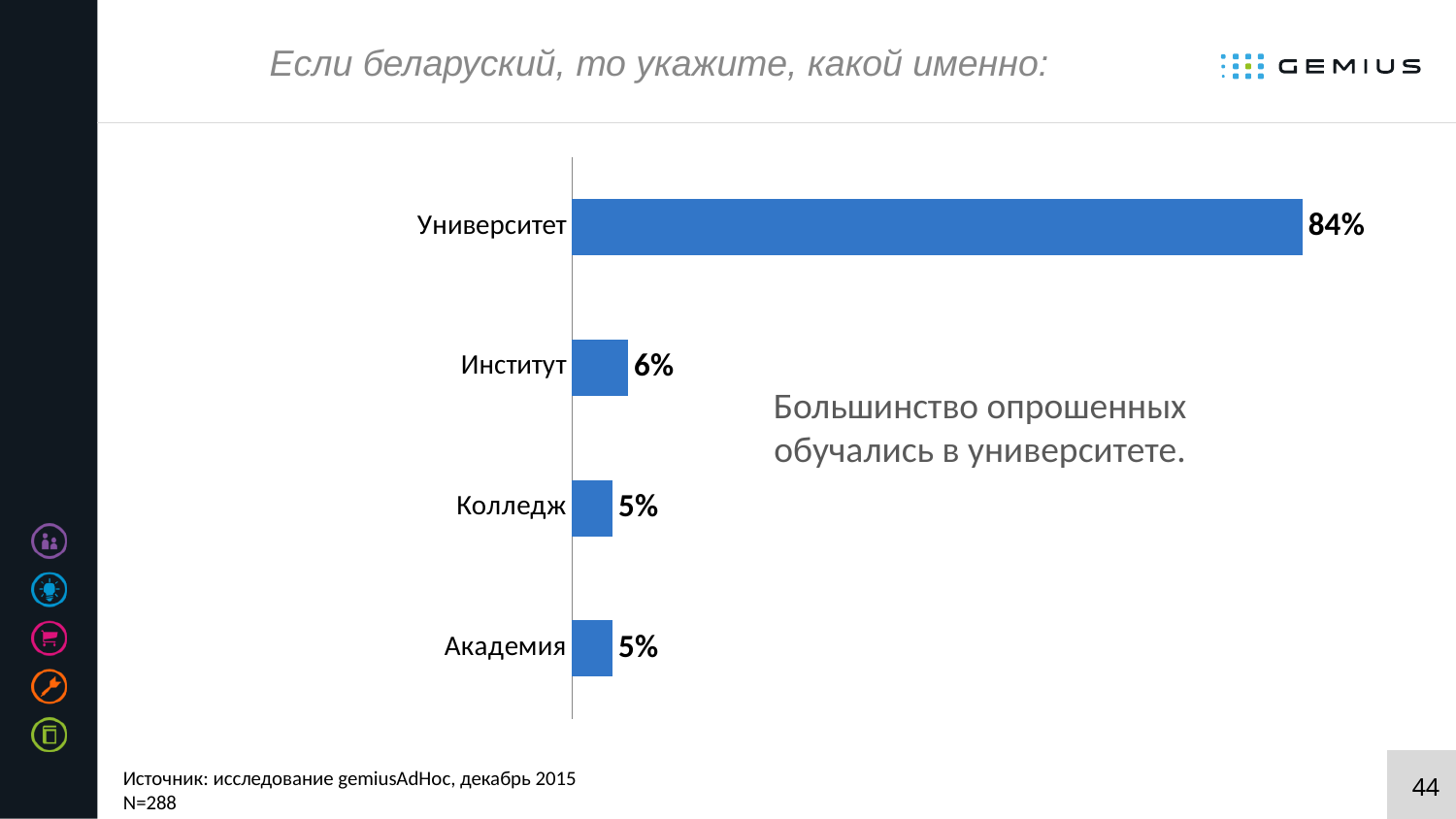
Which category has the highest value? Университет What kind of chart is shown on the slide? Bar chart Which is larger, the value for Университет or the value for Институт? Университет What is the value for Университет? 84% What is the difference between the values for Университет and Институт? 78% What is the title of the slide? Если беларуский, то укажите, какой именно: What is the value for Институт? 6% How many categories are shown in the chart? 4 What is the value for Колледж? 5% What is the value for Академия? 5% What is the sample size (N) stated on the slide? N=288 What is the difference between the values for Институт and Колледж? 1%